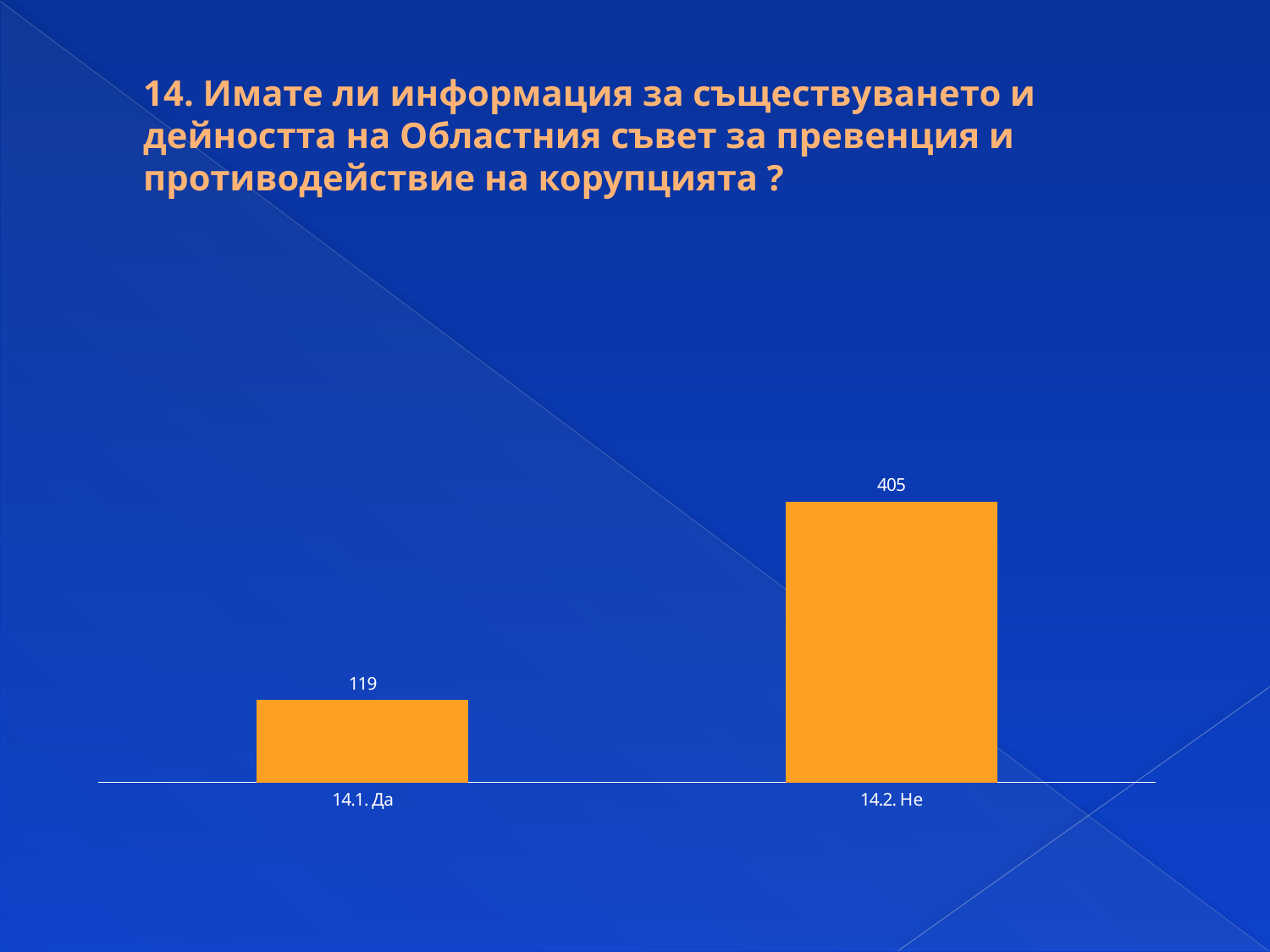
What is the number of the survey question shown in the slide title? 14 Which category has the highest value? 14.2. Не What colour are the bars in the chart? Orange What is the value for 14.2. Не? 405 What is the value for 14.1. Да? 119 Which is larger, the value for 14.1. Да or the value for 14.2. Не? 14.2. Не Which category has the lowest value? 14.1. Да What is the difference between the values for 14.2. Не and 14.1. Да? 286 How many categories are shown in the chart? 2 What is the total of the two values shown in the chart? 524 What kind of chart is shown on the slide? Bar chart